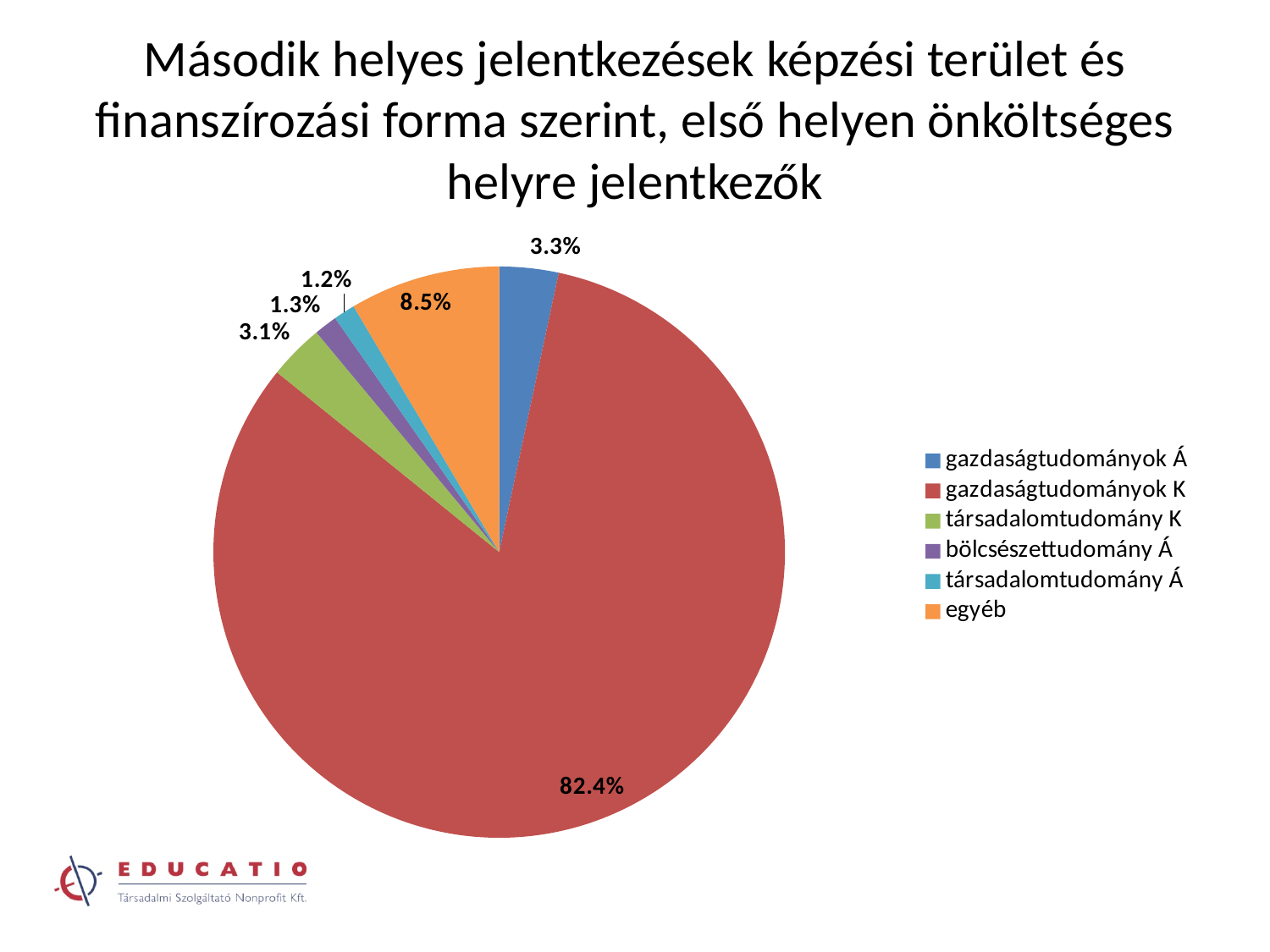
Which is larger, egyéb or gazdaságtudományok Á? egyéb What kind of chart is shown on the slide? pie chart How many categories does the legend list? 6 Which category has the smallest slice of the pie? társadalomtudomány Á What is the difference between the values for egyéb and társadalomtudomány K? 5.4% What share of the pie does gazdaságtudományok K have? 82.4% What is the value for bölcsészettudomány Á? 1.3% Which category has the largest slice of the pie? gazdaságtudományok K What is the value for egyéb? 8.5% What is the value for gazdaságtudományok Á? 3.3% What colour is the slice for gazdaságtudományok K? red What is the value for társadalomtudomány K? 3.1%